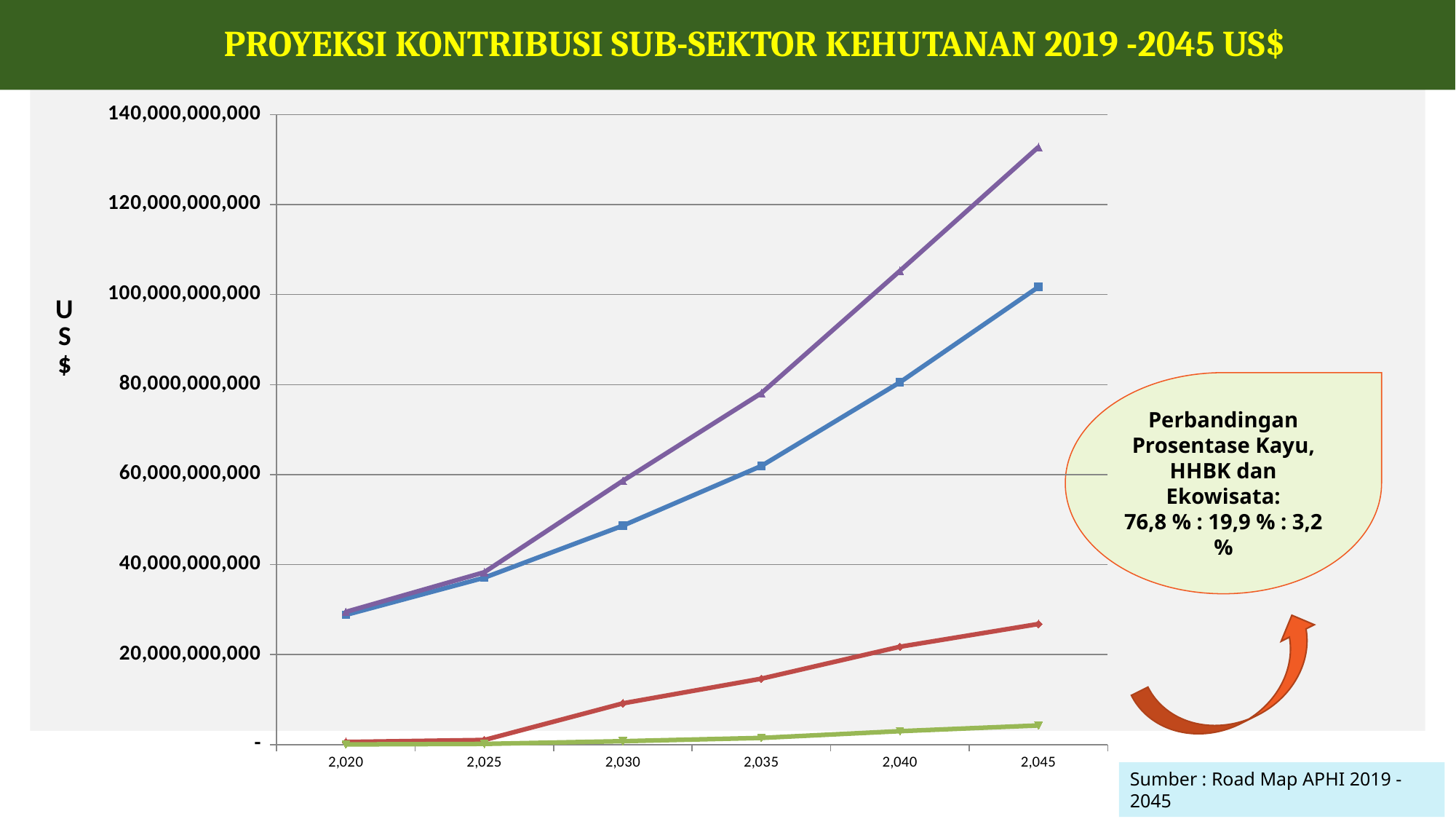
What is the label on the vertical axis of the chart? US$ Do the values of the purple line rise or fall from 2,020 to 2,045? Rise Is the value of the purple line at 2,045 greater or less than 120,000,000,000? greater At 2,045, which is larger: the value of the purple line or the value of the blue line? The purple line Is the value of the blue line at 2,045 greater or less than 120,000,000,000? less How many year points are shown along the x axis of the chart? 6 Which line has the lowest value at 2,045? The green line Is the value of the red line at 2,045 greater or less than 20,000,000,000? greater How many lines are plotted on the chart? 4 What kind of chart is shown on the slide? Line chart Which line has the highest value at 2,045? The purple line What is the title of the chart on the slide? PROYEKSI KONTRIBUSI SUB-SEKTOR KEHUTANAN 2019 -2045 US$